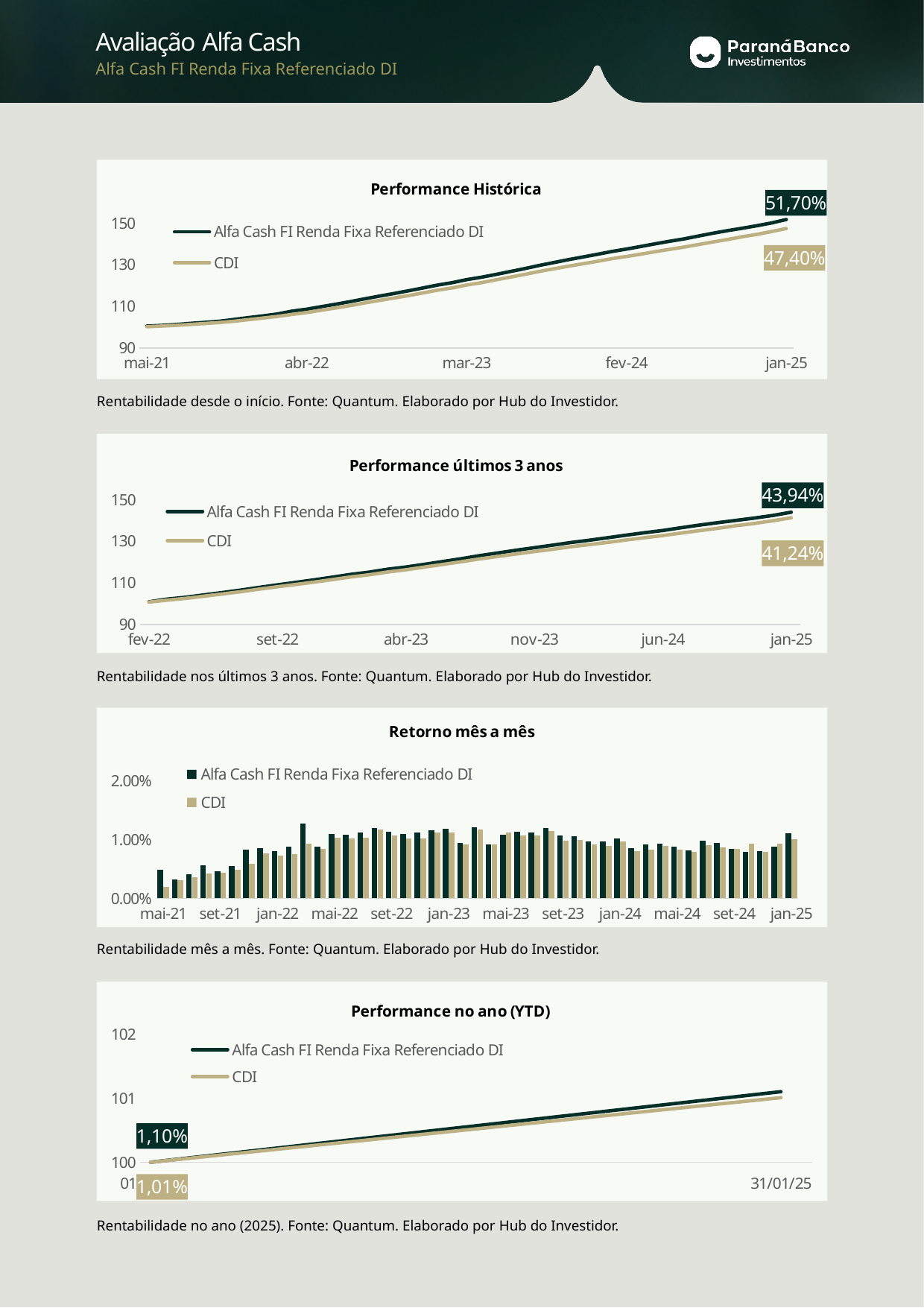
In the 'Performance no ano (YTD)' chart, what is the labelled value for CDI? 1,01% In the 'Performance no ano (YTD)' chart, what is the labelled value for Alfa Cash FI Renda Fixa Referenciado DI? 1,10% In the 'Performance últimos 3 anos' chart, what is the labelled value for CDI? 41,24% In the 'Performance Histórica' chart, what is the final value labelled for Alfa Cash FI Renda Fixa Referenciado DI? 51,70% In the 'Performance últimos 3 anos' chart, what is the labelled value for Alfa Cash FI Renda Fixa Referenciado DI? 43,94% How many series does the legend of the 'Retorno mês a mês' chart list? 2 In the 'Performance Histórica' chart, what is the difference between the labelled values for Alfa Cash FI Renda Fixa Referenciado DI and CDI? 4,30 percentage points In the 'Performance últimos 3 anos' chart, which series has the higher labelled value, Alfa Cash FI Renda Fixa Referenciado DI or CDI? Alfa Cash FI Renda Fixa Referenciado DI What kind of chart is 'Retorno mês a mês'? Bar chart What is the title of the second chart on the slide? Performance últimos 3 anos In the 'Performance Histórica' chart, do the values rise or fall from mai-21 to jan-25? Rise In the 'Performance Histórica' chart, what is the final value labelled for CDI? 47,40%